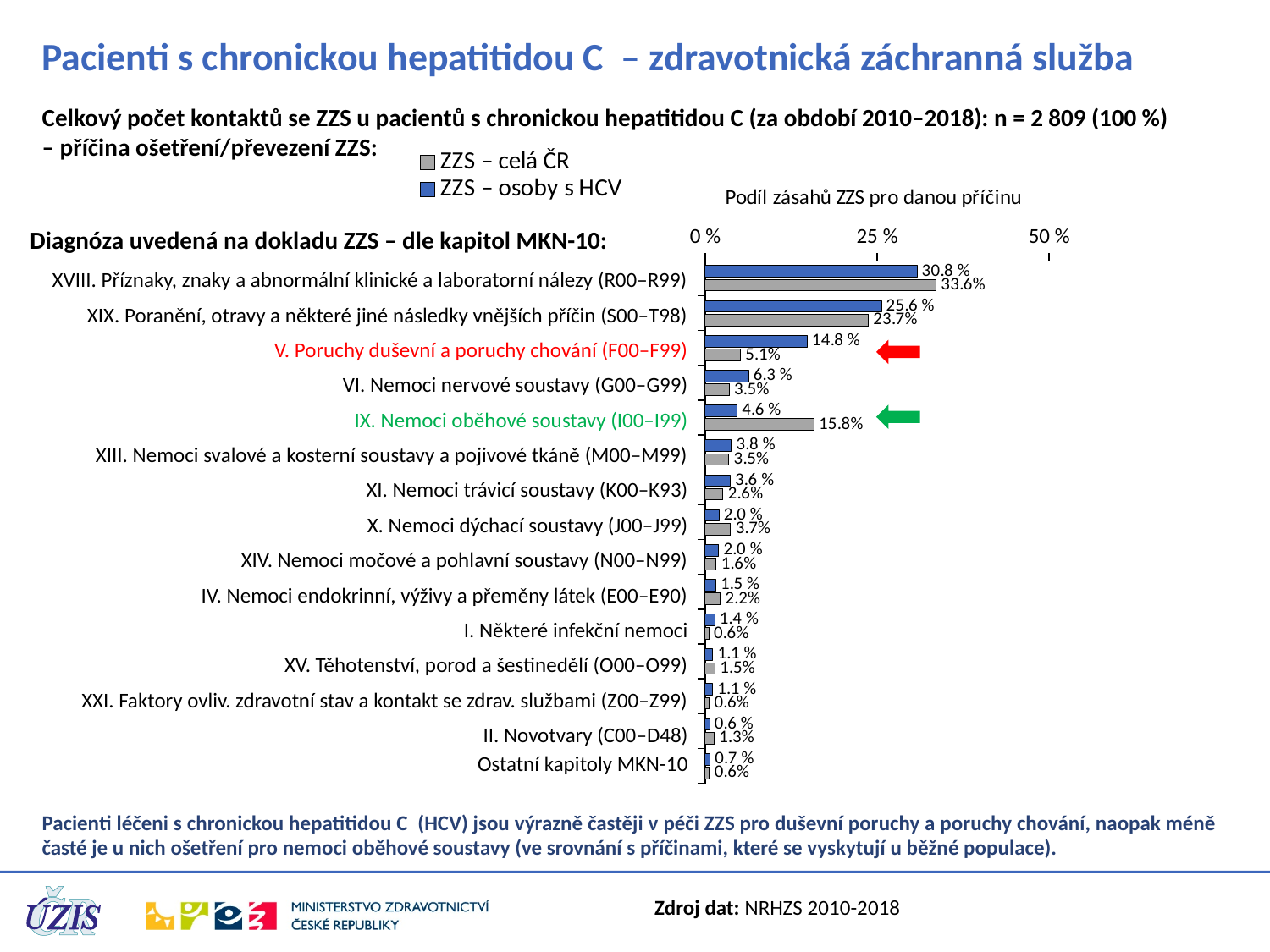
Is the 'ZZS – osoby s HCV' value for 'XVIII. Příznaky, znaky a abnormální klinické a laboratorní nálezy (R00–R99)' greater or less than 25 %? greater What is the value for 'ZZS – osoby s HCV' in the category 'V. Poruchy duševní a poruchy chování (F00–F99)'? 14.8 % Which category has the highest value for the 'ZZS – osoby s HCV' series? XVIII. Příznaky, znaky a abnormální klinické a laboratorní nálezy (R00–R99) How many diagnosis categories are plotted in the chart? 15 What kind of chart is shown on the slide? bar chart What is the value for 'ZZS – celá ČR' in the category 'IX. Nemoci oběhové soustavy (I00–I99)'? 15.8% What is the value for 'ZZS – celá ČR' in the category 'XVIII. Příznaky, znaky a abnormální klinické a laboratorní nálezy (R00–R99)'? 33.6% What is the title shown above the chart's horizontal axis? Podíl zásahů ZZS pro danou příčinu How many series does the chart legend list? 2 What is the difference between the 'ZZS – osoby s HCV' and 'ZZS – celá ČR' values for 'V. Poruchy duševní a poruchy chování (F00–F99)'? 9.7 percentage points For 'IX. Nemoci oběhové soustavy (I00–I99)', which series has the larger value: 'ZZS – osoby s HCV' or 'ZZS – celá ČR'? ZZS – celá ČR Which category has the lowest value for the 'ZZS – osoby s HCV' series? II. Novotvary (C00–D48)